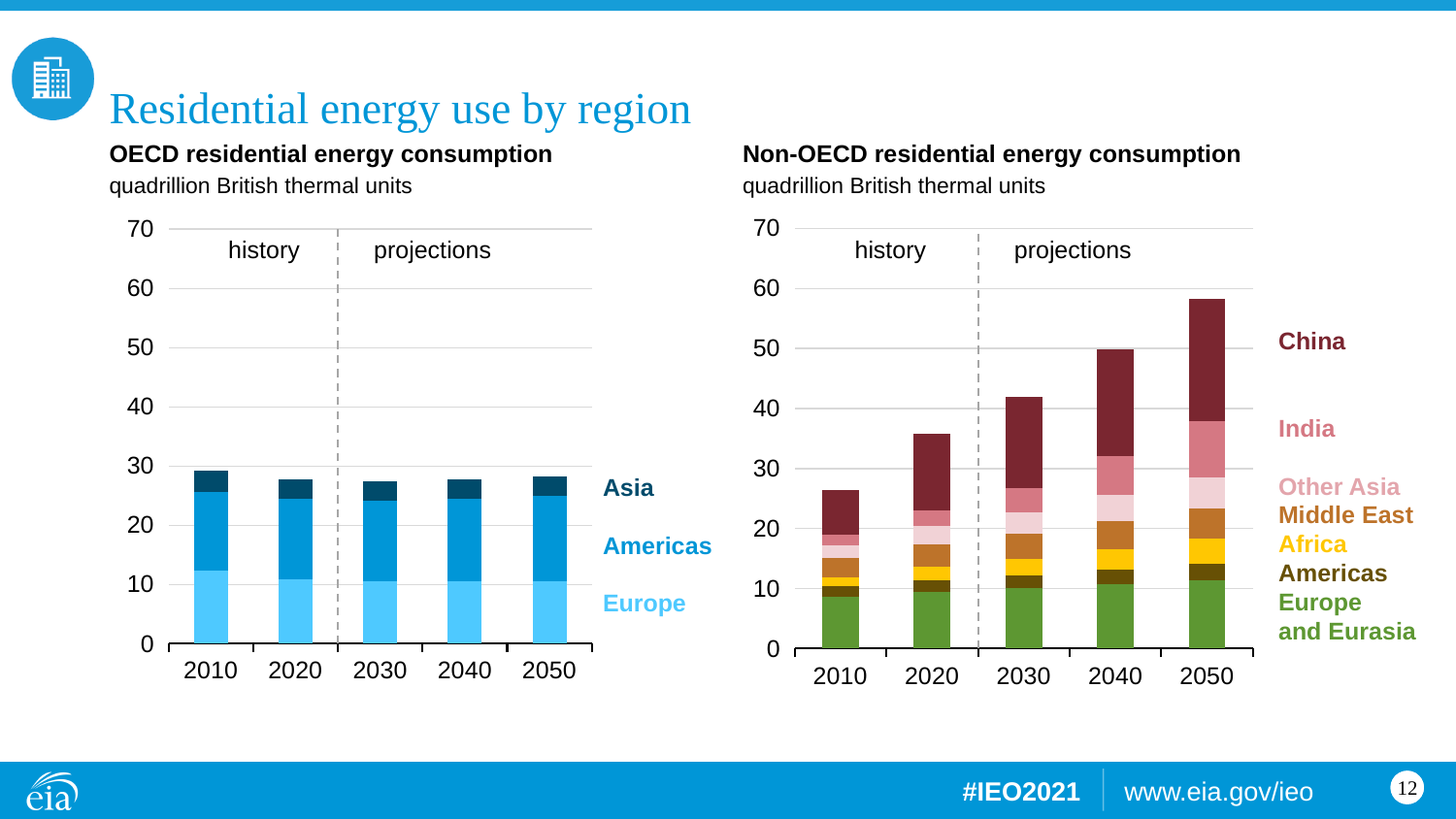
In the Non-OECD residential energy consumption chart, is the total for 2010 greater or less than 30? less How many regions are listed in the legend of the Non-OECD residential energy consumption chart? 7 In the Non-OECD residential energy consumption chart, is the total for 2050 greater or less than 50? greater Which is larger in 2050: the total in the OECD residential energy consumption chart or the total in the Non-OECD residential energy consumption chart? Non-OECD How many years are shown on the x axis of the Non-OECD residential energy consumption chart? 5 In the OECD residential energy consumption chart, is the total for 2030 greater or less than 40? less In the Non-OECD residential energy consumption chart, which year has the highest total consumption? 2050 How many regions are listed in the legend of the OECD residential energy consumption chart? 3 What kind of chart is the OECD residential energy consumption chart? stacked bar chart In the Non-OECD residential energy consumption chart, which year has the lowest total consumption? 2010 What unit is used on the y axis of both charts? quadrillion British thermal units In the Non-OECD residential energy consumption chart, do total values rise or fall from 2010 to 2050? rise